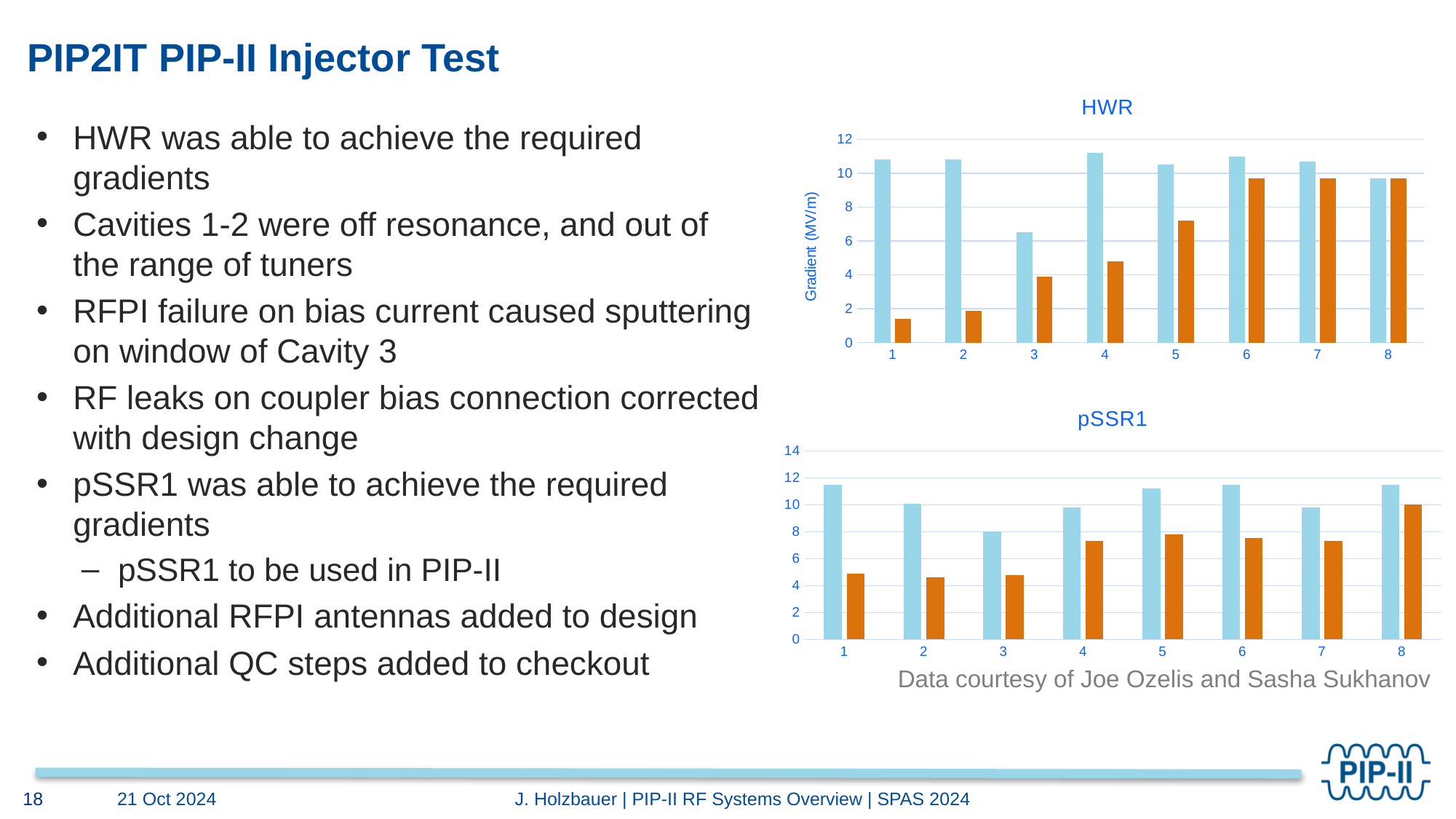
What is the y-axis label of the HWR chart? Gradient (MV/m) In the HWR chart, is the orange bar for category 1 greater or less than 2? less In the HWR chart, which category has the lowest light blue bar? 3 How many categories are shown on the x axis of the pSSR1 chart? 8 In the HWR chart, do the orange bars generally rise or fall from category 1 to category 8? rise In the pSSR1 chart, which category has the lowest light blue bar? 3 In the pSSR1 chart, which is larger for category 4, the light blue bar or the orange bar? the light blue bar What kind of chart is the HWR chart? bar chart In the HWR chart, which category has the lowest orange bar? 1 In the HWR chart, is the light blue bar for category 4 greater or less than 10? greater In the pSSR1 chart, is the orange bar for category 2 greater or less than 6? less